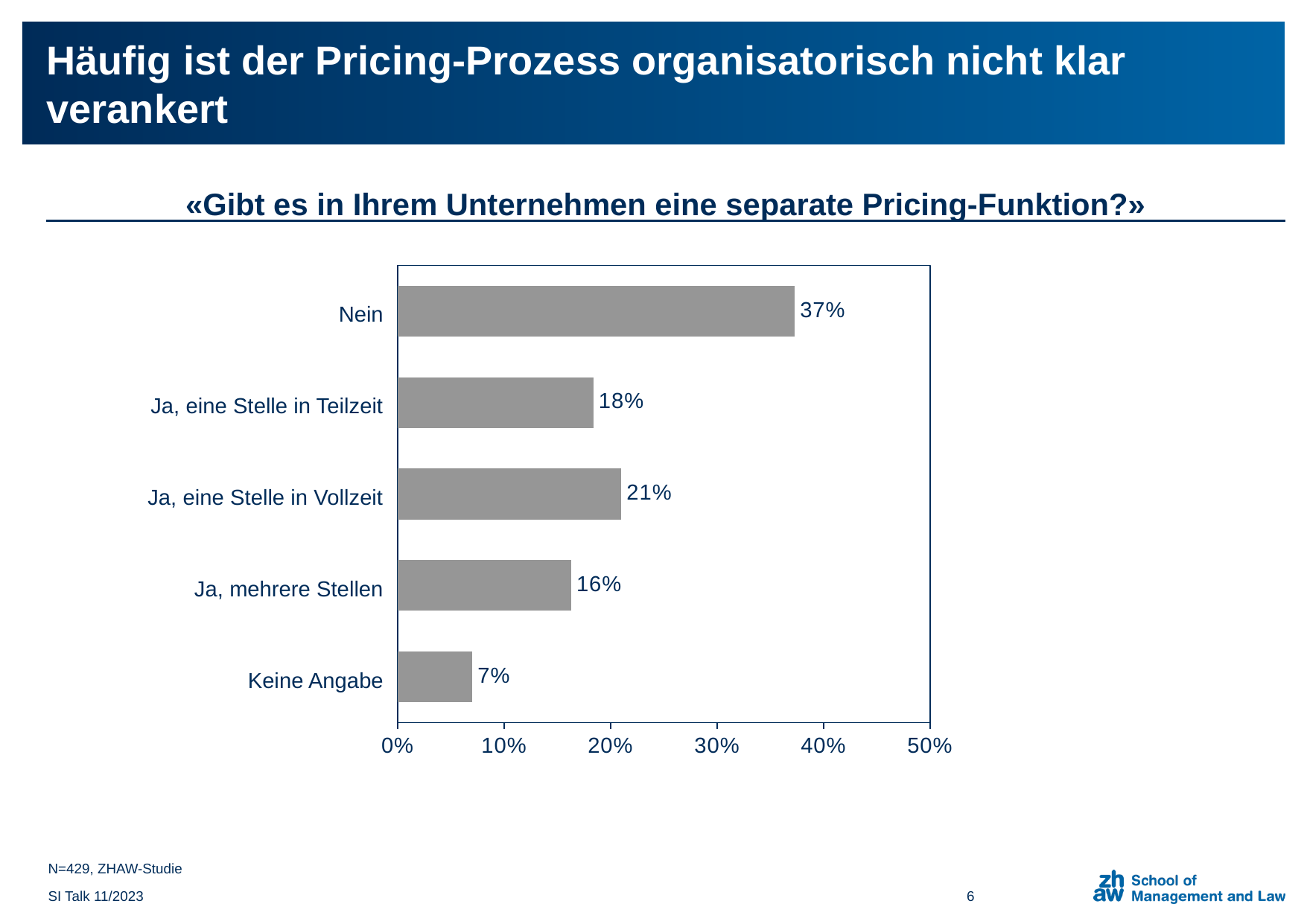
What percentage of respondents answered "Nein"? 37% How many categories are shown in the chart? 5 Which category has the highest value? Nein What is the maximum value shown on the x axis? 50% Is the value for "Nein" greater or less than 30%? greater What is the value for "Keine Angabe"? 7% Which is larger: "Ja, eine Stelle in Teilzeit" or "Ja, mehrere Stellen"? Ja, eine Stelle in Teilzeit What question is the chart based on, as shown in the chart heading? «Gibt es in Ihrem Unternehmen eine separate Pricing-Funktion?» What kind of chart is shown on the slide? Bar chart What is the value for "Ja, eine Stelle in Vollzeit"? 21% Which category has the lowest value? Keine Angabe What is the difference between the values for "Nein" and "Ja, eine Stelle in Vollzeit"? 16%